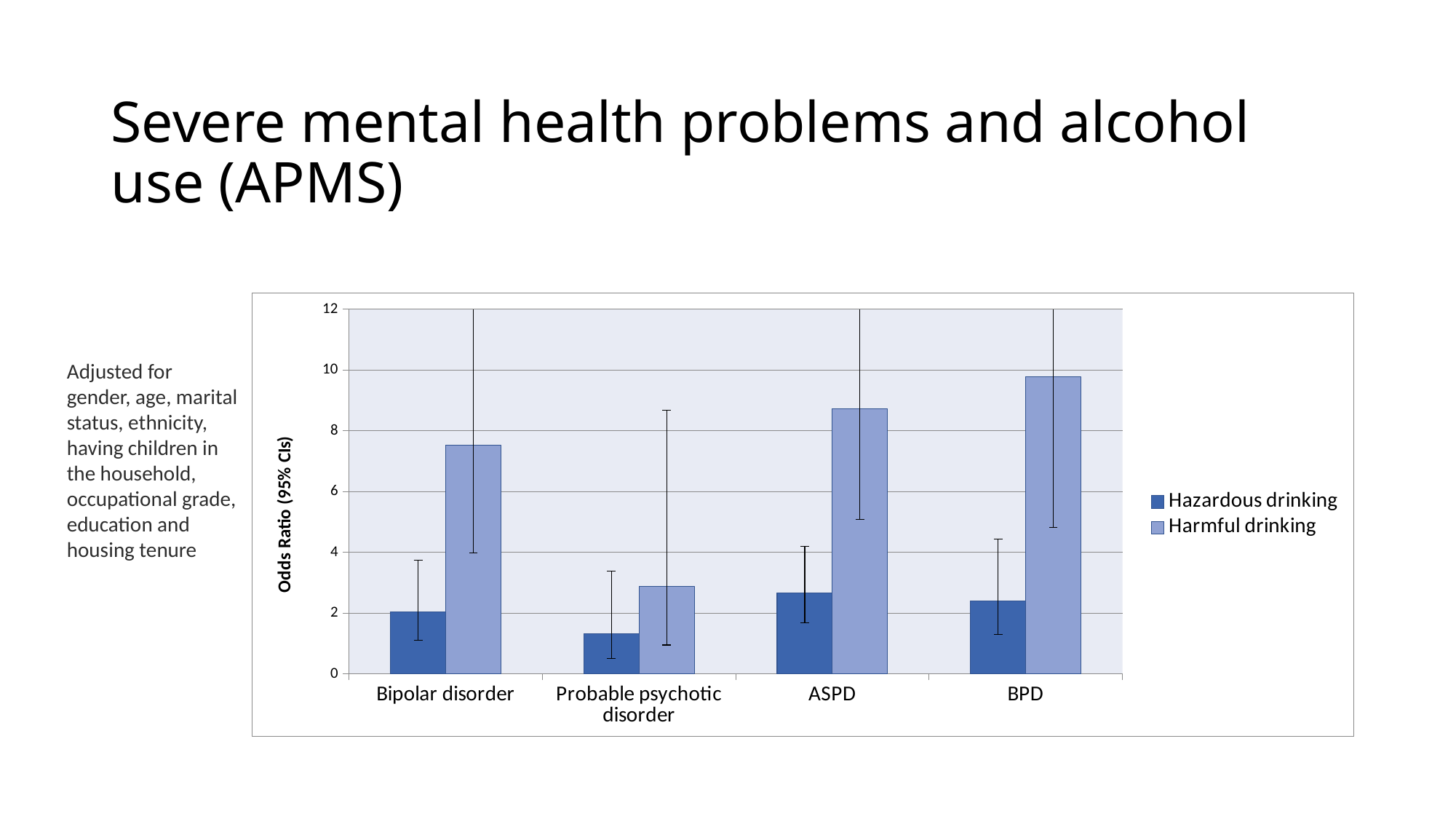
What is the label of the y axis? Odds Ratio (95% CIs) Is the Harmful drinking odds ratio for Bipolar disorder greater or less than 6? greater Which is larger: the Harmful drinking odds ratio for BPD or for ASPD? BPD Is the Hazardous drinking odds ratio for ASPD greater or less than 4? less Which category has the lowest odds ratio for Hazardous drinking? Probable psychotic disorder Which category has the highest odds ratio for Harmful drinking? BPD Is the Harmful drinking odds ratio for Probable psychotic disorder greater or less than 4? less How many series does the legend list? 2 What kind of chart is shown on the slide? Bar chart How many disorder categories are shown on the x axis? 4 Which category has the lowest odds ratio for Harmful drinking? Probable psychotic disorder